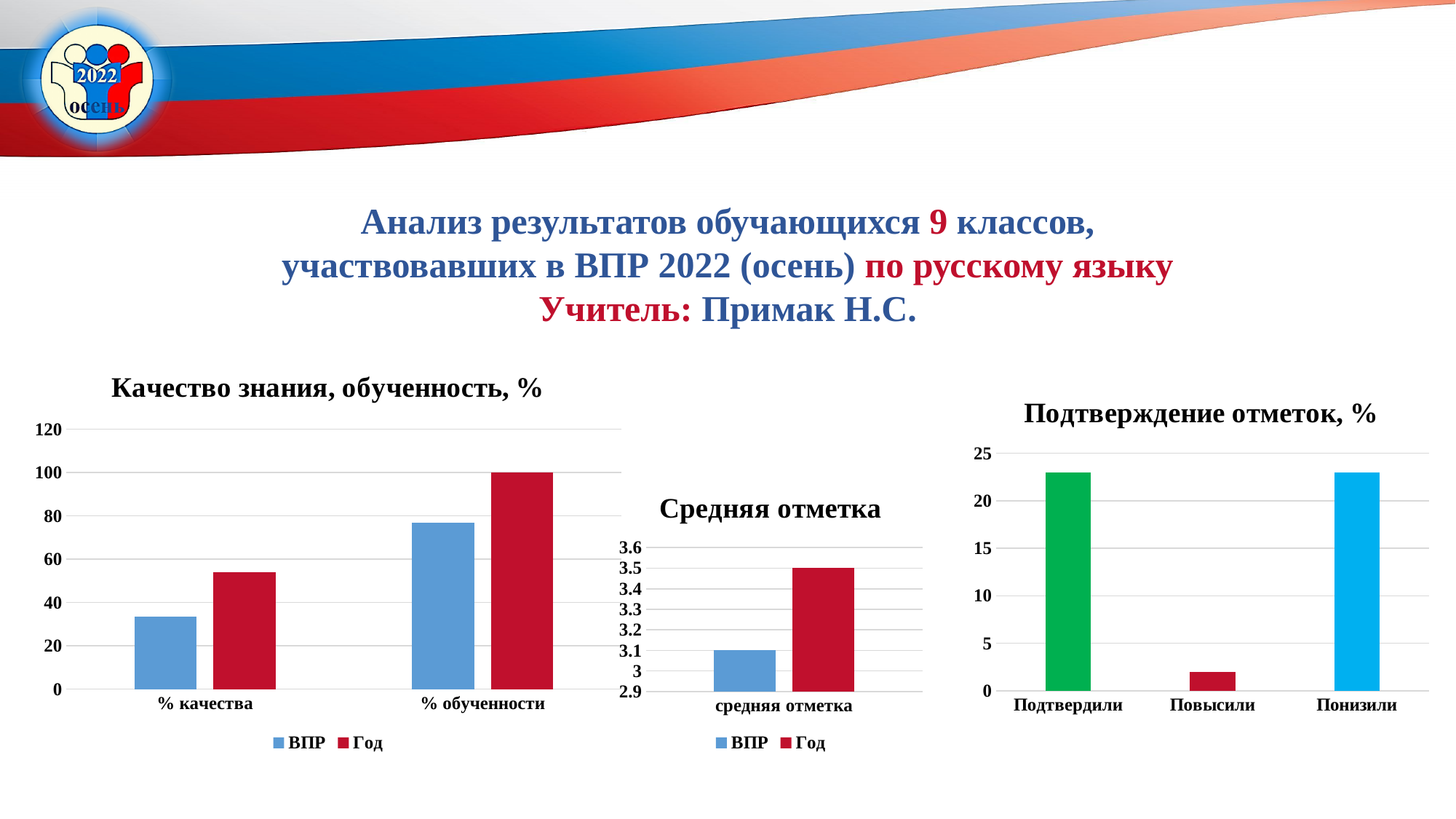
In the chart titled "Средняя отметка", what is the value for Год? 3.5 In the chart titled "Качество знания, обученность, %", which series has the larger value for % качества, ВПР or Год? Год In the chart titled "Качество знания, обученность, %", is the value of ВПР for % обученности greater or less than 60? greater In the chart titled "Средняя отметка", what is the value for ВПР? 3.1 In the chart titled "Подтверждение отметок, %", which category has the lowest value? Повысили In the chart titled "Качество знания, обученность, %", how many series does the legend list? 2 In the chart titled "Качество знания, обученность, %", what is the value of Год for % обученности? 100 In the chart titled "Подтверждение отметок, %", how many categories are shown on the x axis? 3 In the chart titled "Подтверждение отметок, %", is the value for Подтвердили greater or less than 20? greater In the chart titled "Средняя отметка", what is the difference between the Год value and the ВПР value? 0.4 In the chart titled "Качество знания, обученность, %", what kind of chart is shown? bar chart In the chart titled "Качество знания, обученность, %", is the value of ВПР for % качества greater or less than 40? less